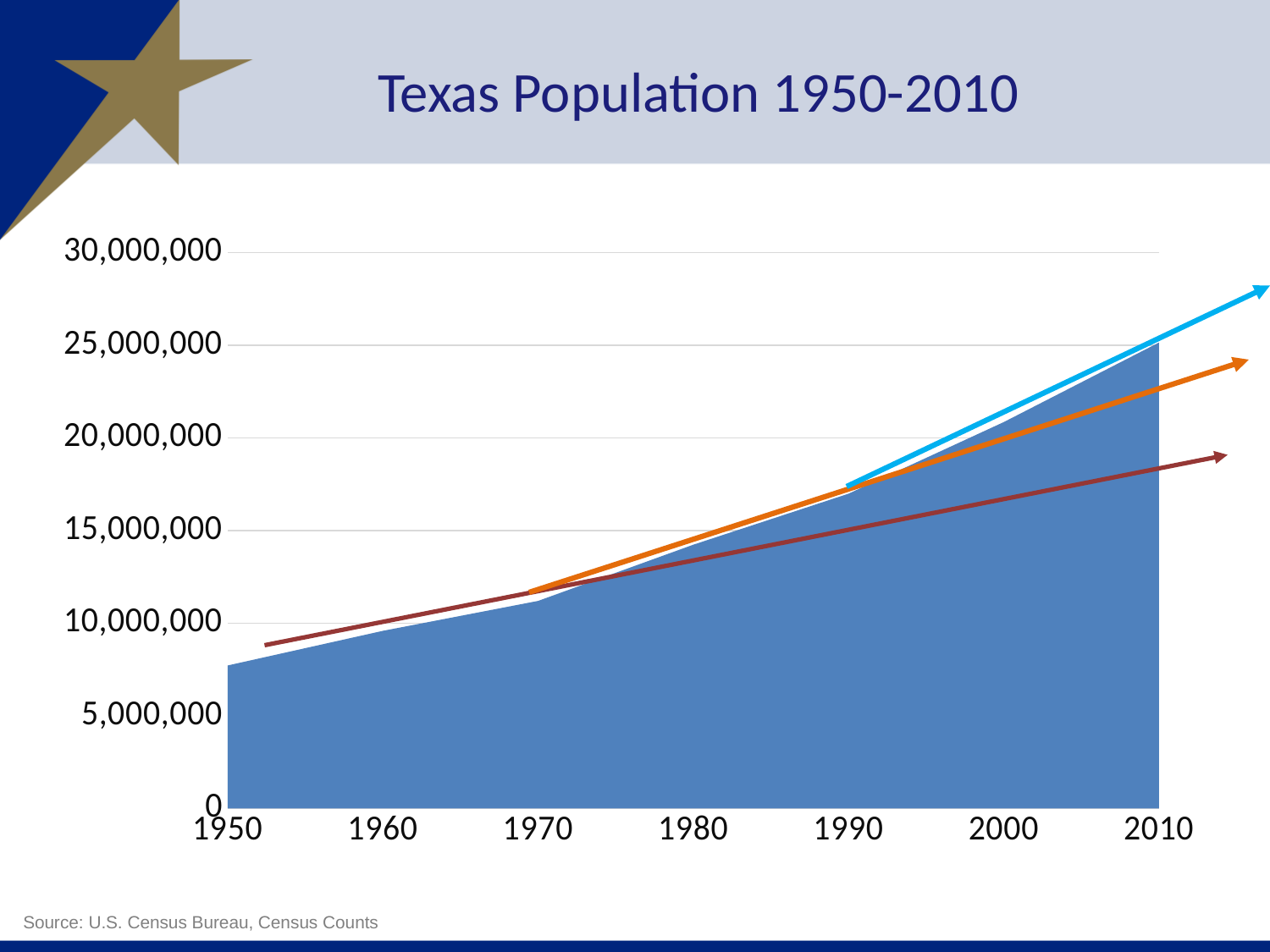
What kind of chart is shown on the slide? Area chart Is the population value for 2010 greater or less than 20,000,000? greater Which year has the highest population value in the chart? 2010 Which year has the larger population value, 1980 or 2000? 2000 Which year has the lowest population value in the chart? 1950 Is the population value for 1990 greater or less than 15,000,000? greater What source is cited at the bottom of the slide for the chart data? U.S. Census Bureau, Census Counts Is the population value for 1950 greater or less than 10,000,000? less What is the title of the chart? Texas Population 1950-2010 Does the Texas population rise or fall from 1950 to 2010? Rise How many years are marked along the x axis of the chart? 7